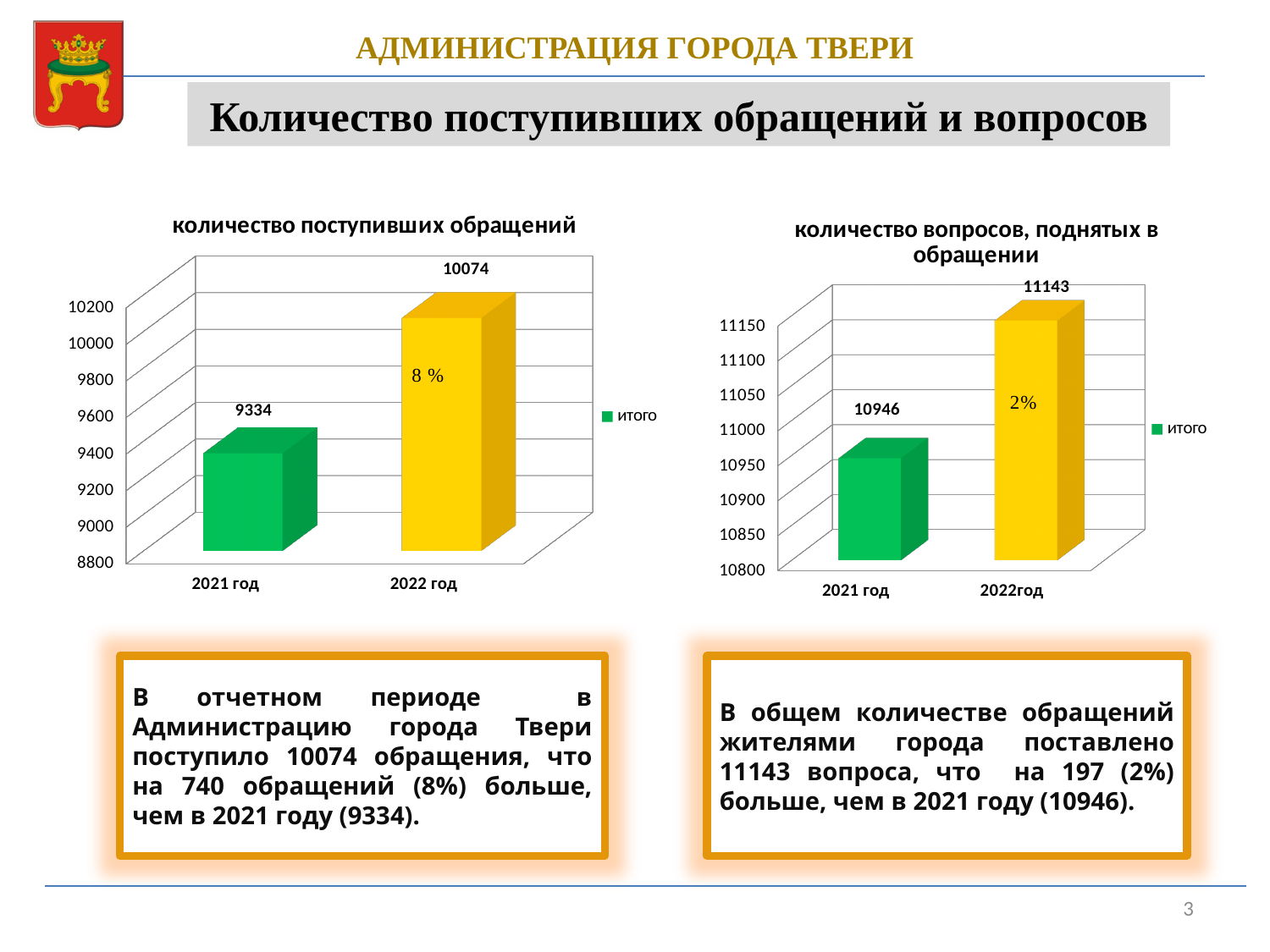
In the chart titled "количество поступивших обращений", which year has the higher value? 2022 год What kind of chart is the chart titled "количество поступивших обращений"? bar chart In the chart titled "количество вопросов, поднятых в обращении", what is the difference between the 2022год and 2021 год values? 197 In the chart titled "количество поступивших обращений", what is the value for 2021 год? 9334 In the chart titled "количество поступивших обращений", is the value for 2021 год greater or less than 9400? less In the chart titled "количество поступивших обращений", what is the value for 2022 год? 10074 In the chart titled "количество поступивших обращений", what is the difference between the 2022 год and 2021 год values? 740 In the chart titled "количество вопросов, поднятых в обращении", which year has the lower value? 2021 год In the chart titled "количество вопросов, поднятых в обращении", what is the value for 2021 год? 10946 How many categories are shown on the x axis of the chart titled "количество вопросов, поднятых в обращении"? 2 What is the legend entry shown in the chart titled "количество вопросов, поднятых в обращении"? итого In the chart titled "количество вопросов, поднятых в обращении", what is the value for 2022год? 11143